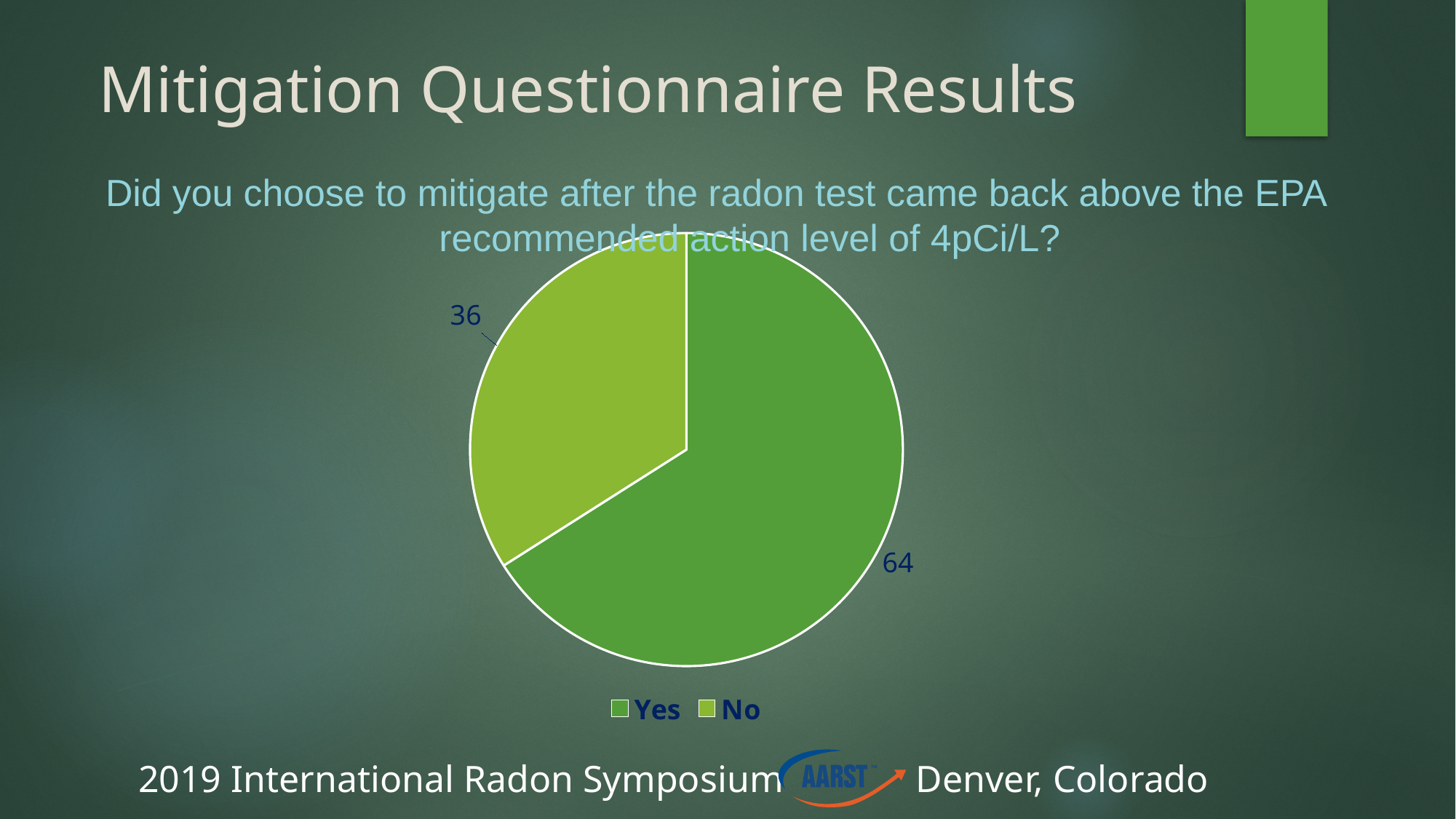
What is the value for Yes? 64 Which category has the largest slice? Yes What is the difference between the Yes and No values? 28 Which is larger, Yes or No? Yes How many entries does the legend list? 2 Which category has the smallest slice? No What is the value for No? 36 How many slices does the pie chart have? 2 What question does the chart's title ask? Did you choose to mitigate after the radon test came back above the EPA recommended action level of 4pCi/L? What kind of chart is shown on the slide? pie chart What is the total of the two slice values? 100